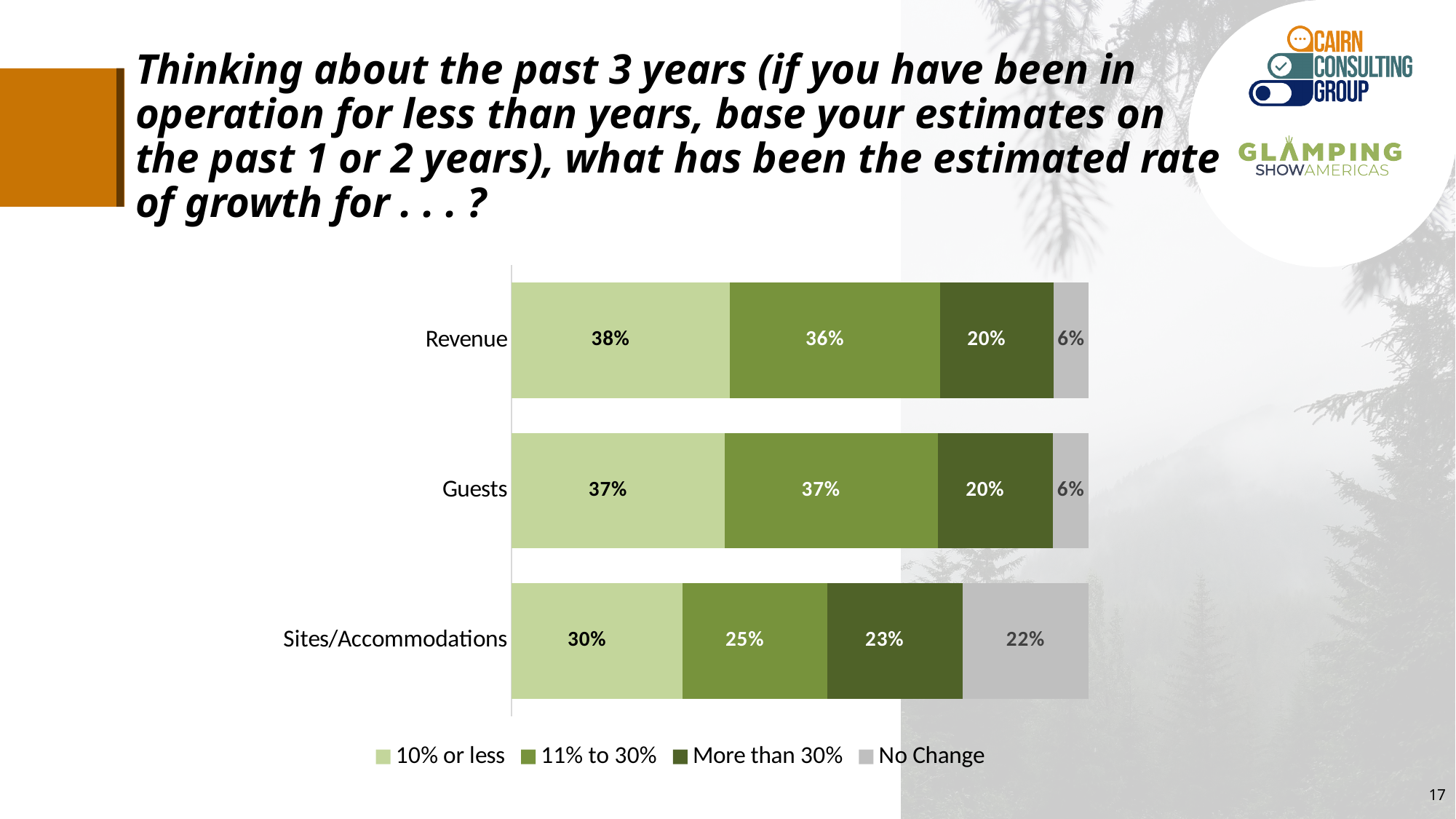
Which category has the highest 'No Change' value? Sites/Accommodations What is the value for '11% to 30%' in the Sites/Accommodations bar? 25% What is the total of the Guests bar? 100% What is the value for 'No Change' in the Sites/Accommodations bar? 22% What kind of chart is shown on the slide? Stacked bar chart What percentage reported 'More than 30%' growth for Guests? 20% What percentage of respondents reported a growth rate of 10% or less for Revenue? 38% Which is larger: the '11% to 30%' value for Revenue or for Sites/Accommodations? Revenue What is the difference between the 'No Change' values for Sites/Accommodations and Revenue? 16% How many categories are shown on the chart? 3 How many series does the legend list? 4 Which category has the lowest '10% or less' value? Sites/Accommodations